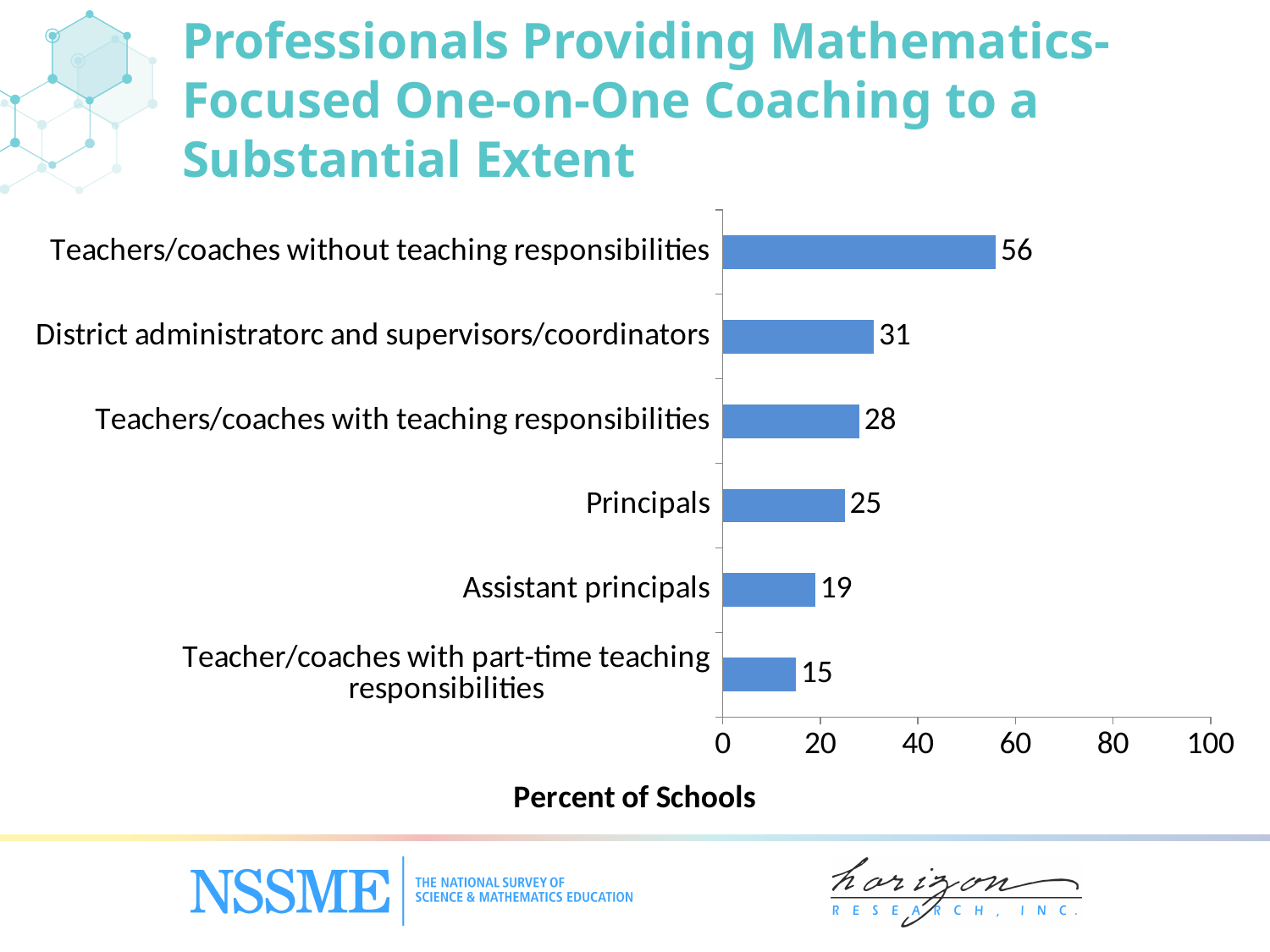
What is the value for Teacher/coaches with part-time teaching responsibilities? 15 How many categories are shown in the chart? 6 What is the difference between the values for Teachers/coaches without teaching responsibilities and Teachers/coaches with teaching responsibilities? 28 What kind of chart is shown on the slide? Bar chart Which category has the lowest percent of schools? Teacher/coaches with part-time teaching responsibilities Is the value for Assistant principals greater or less than 20? less What is the value for Assistant principals? 19 Which category has the highest percent of schools? Teachers/coaches without teaching responsibilities What is the value for Principals? 25 What is the label of the horizontal axis? Percent of Schools What percent of schools have teachers/coaches without teaching responsibilities providing mathematics-focused one-on-one coaching to a substantial extent? 56 Which is larger: the value for District administratorc and supervisors/coordinators or the value for Principals? District administratorc and supervisors/coordinators